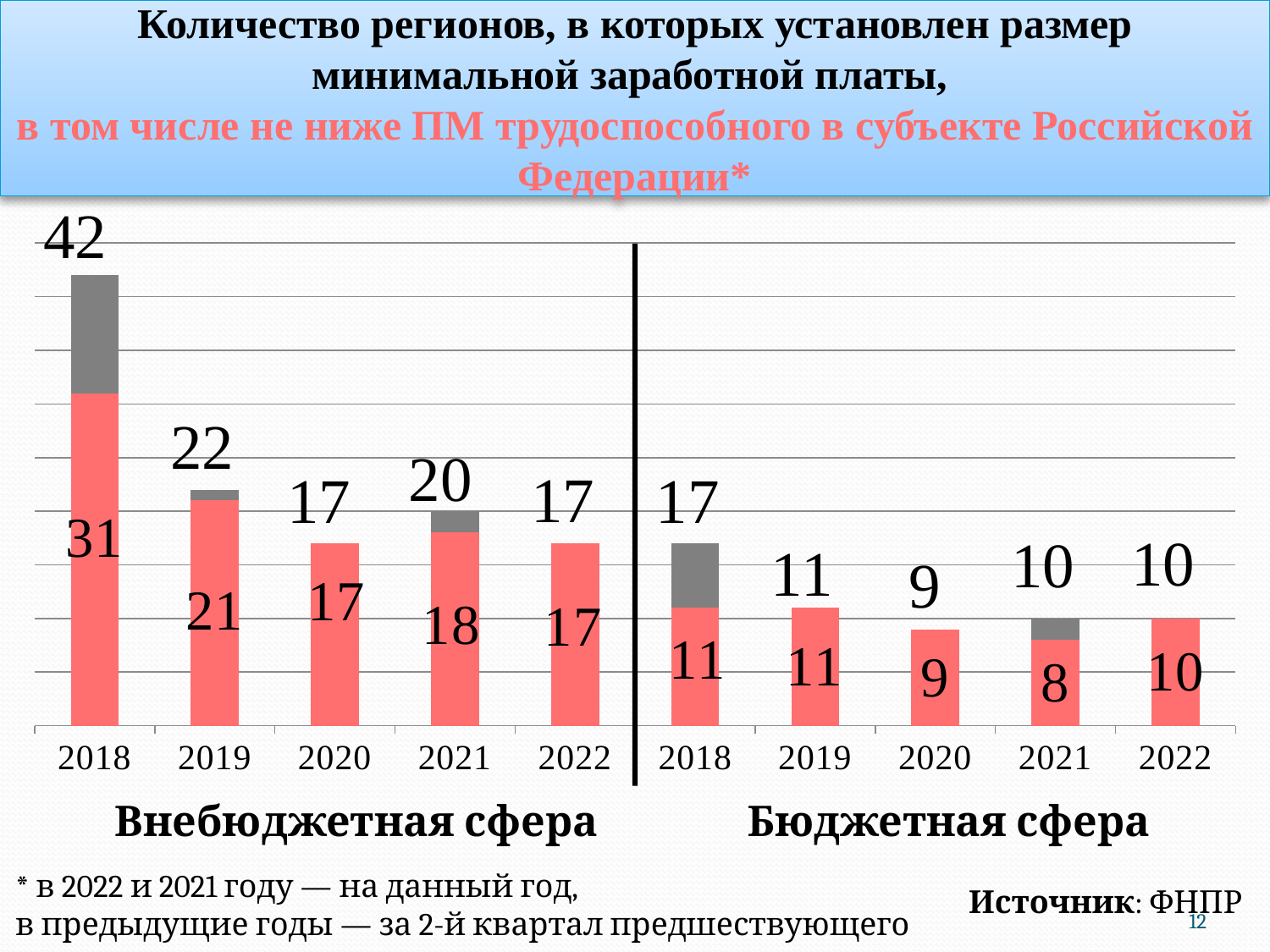
What is the total number of regions shown for 2018 in the Внебюджетная сфера group? 42 What is the value of the red (lower) segment for 2019 in the Внебюджетная сфера group? 21 What kind of chart is shown on the slide? Stacked bar chart How many bars are plotted on the chart in total across both groups? 10 Which is larger: the total for 2021 in the Внебюджетная сфера group or the total for 2018 in the Бюджетная сфера group? 2021 in the Внебюджетная сфера group What is the value of the red (lower) segment for 2021 in the Бюджетная сфера group? 8 What source is cited for the chart data? ФНПР Which year has the lowest total in the Бюджетная сфера group? 2020 What is the total number of regions shown for 2021 in the Внебюджетная сфера group? 20 Which year has the highest total in the Внебюджетная сфера group? 2018 What is the total number of regions shown for 2020 in the Бюджетная сфера group? 9 What is the difference between the total for 2018 and the total for 2019 in the Внебюджетная сфера group? 20